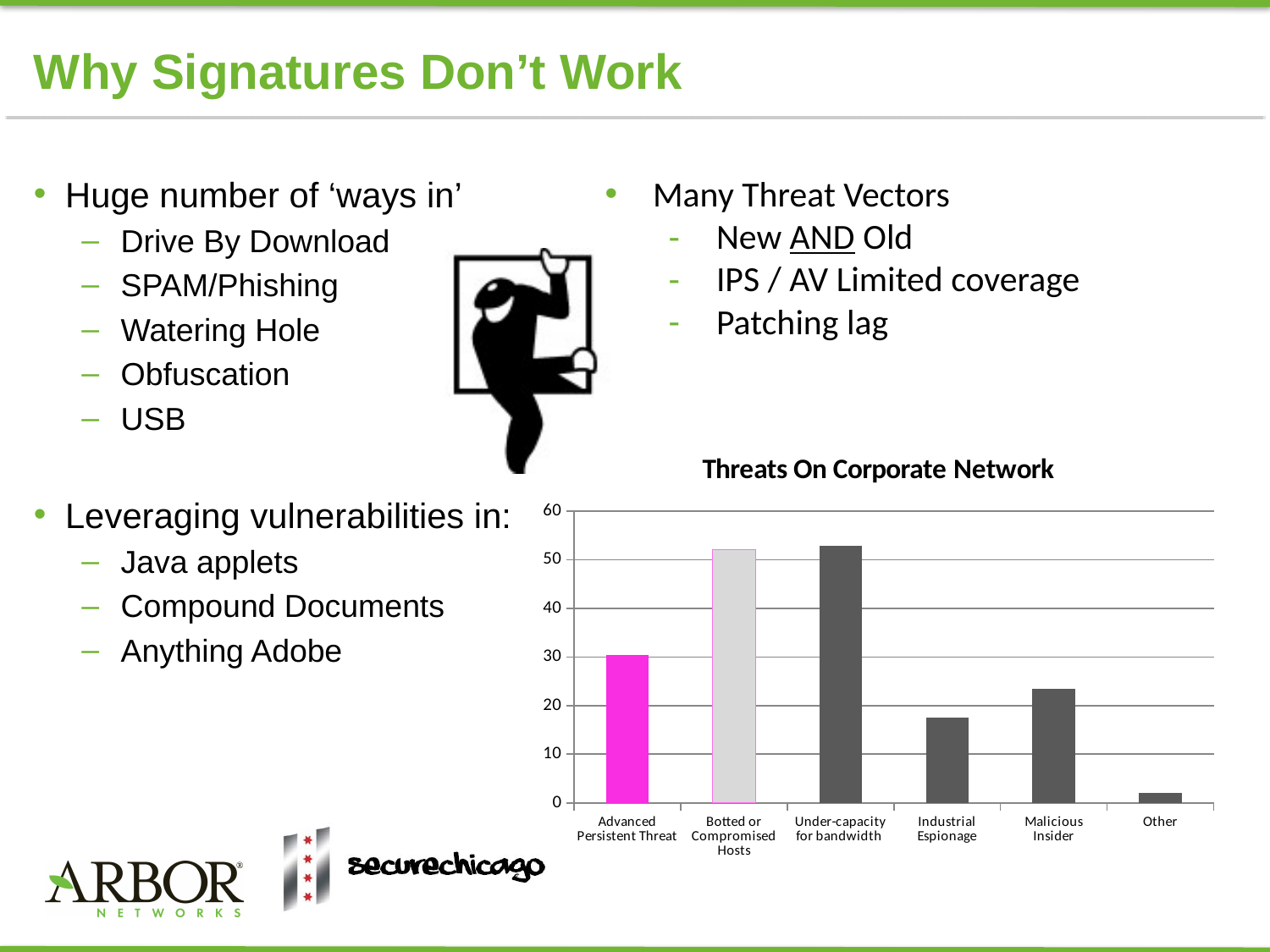
What colour is the bar for Advanced Persistent Threat? magenta (pink) Is the value for Under-capacity for bandwidth greater or less than 50? greater Which is larger, the value for Malicious Insider or the value for Industrial Espionage? Malicious Insider What is the title of the chart on the slide? Threats On Corporate Network Is the value for Industrial Espionage greater or less than 20? less Which is larger, the value for Advanced Persistent Threat or the value for Botted or Compromised Hosts? Botted or Compromised Hosts How many categories are shown on the x axis of the chart? 6 Is the value for Advanced Persistent Threat greater or less than 40? less Which category has the lowest value in the chart? Other What kind of chart is shown on the slide? bar chart